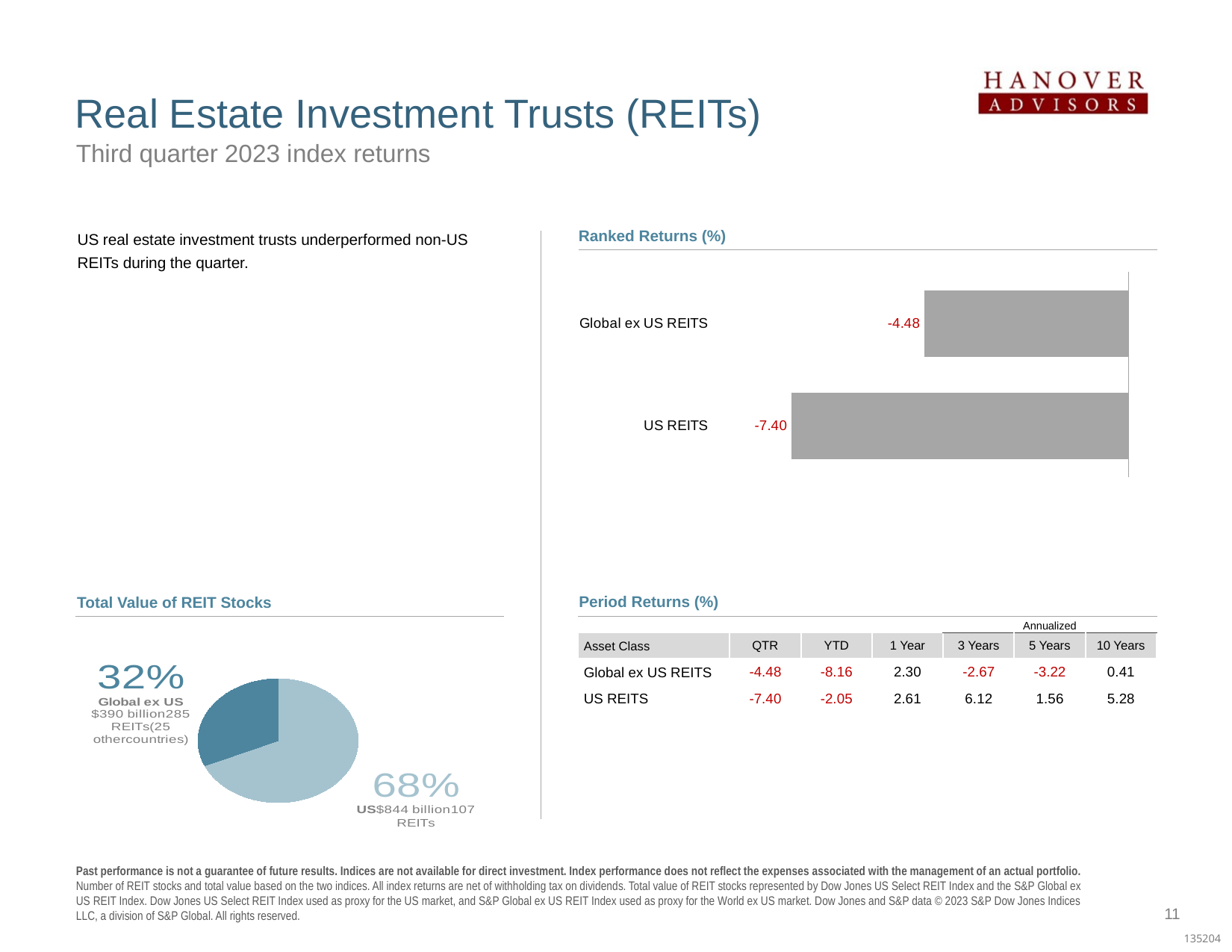
In the Total Value of REIT Stocks chart, what share of the pie is Global ex US? 32% In the Ranked Returns (%) chart, which category has the highest value? Global ex US REITS How many categories are shown in the Ranked Returns (%) chart? 2 In the Ranked Returns (%) chart, what is the difference between the Global ex US REITS and US REITS values? 2.92 In the Total Value of REIT Stocks chart, what share of the pie is US? 68% In the Total Value of REIT Stocks chart, which slice is larger, US or Global ex US? US In the Ranked Returns (%) chart, which is larger, the value for Global ex US REITS or the value for US REITS? Global ex US REITS What kind of chart is the Ranked Returns (%) chart? Bar chart In the Ranked Returns (%) chart, what is the value for US REITS? -7.40 In the Ranked Returns (%) chart, which category has the lowest value? US REITS What kind of chart is the Total Value of REIT Stocks chart? Pie chart In the Ranked Returns (%) chart, what is the value for Global ex US REITS? -4.48